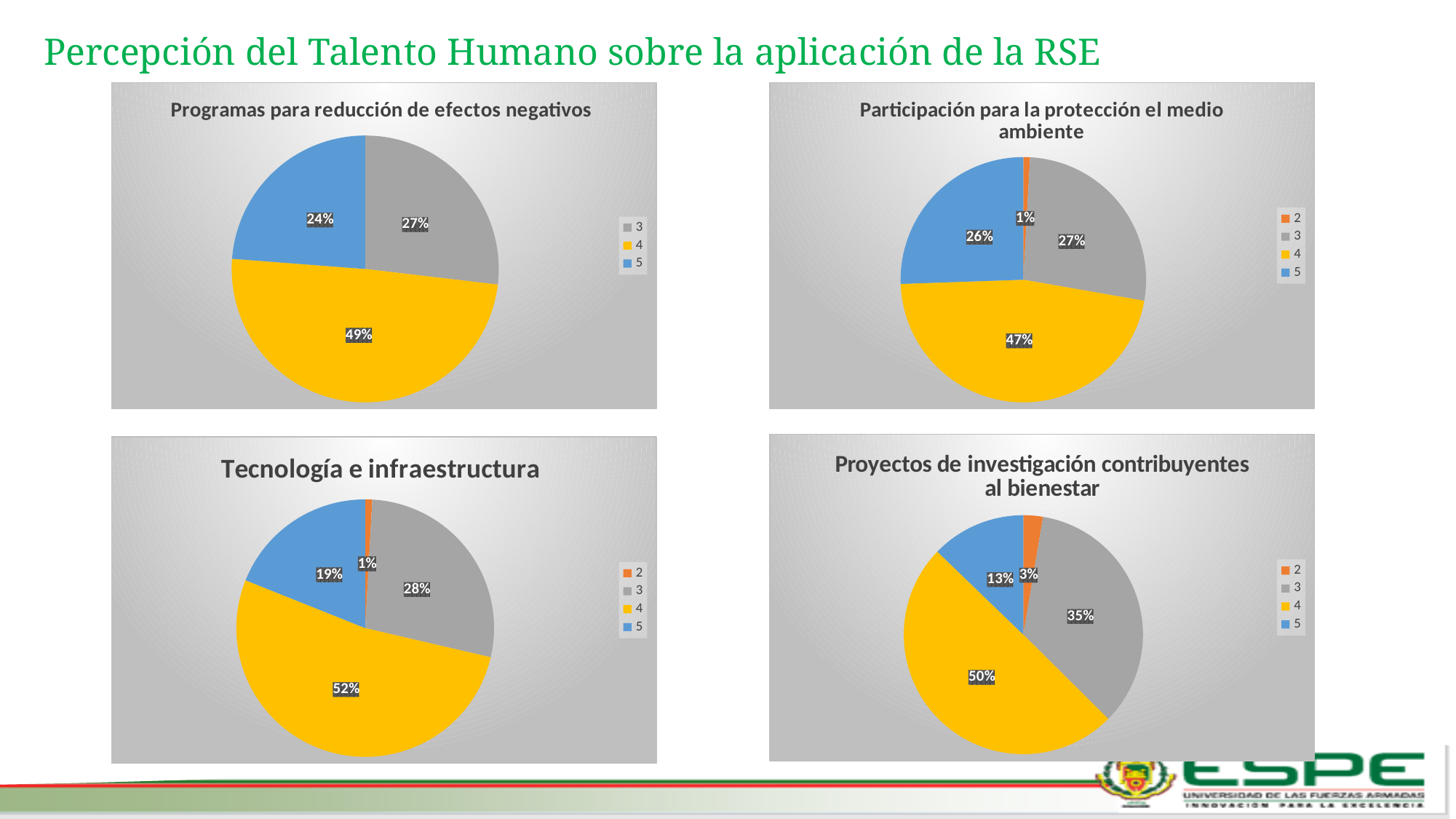
In the 'Programas para reducción de efectos negativos' chart, which category has the smallest slice? 5 In the 'Tecnología e infraestructura' chart, which is larger, the share of category 3 or category 5? 3 In the 'Participación para la protección el medio ambiente' chart, what share does category 2 have? 1% In the 'Proyectos de investigación contribuyentes al bienestar' chart, how many slices does the pie have? 4 In the 'Tecnología e infraestructura' chart, what share does category 5 have? 19% What kind of chart is 'Tecnología e infraestructura'? Pie chart In the 'Participación para la protección el medio ambiente' chart, which category has the largest slice? 4 In the 'Programas para reducción de efectos negativos' chart, what share does category 4 have? 49% How many pie charts are shown on the slide? 4 In the 'Participación para la protección el medio ambiente' chart, what is the difference between the shares of category 4 and category 5? 21% In the 'Proyectos de investigación contribuyentes al bienestar' chart, what share does category 3 have? 35% In the 'Programas para reducción de efectos negativos' chart, how many categories does the legend list? 3